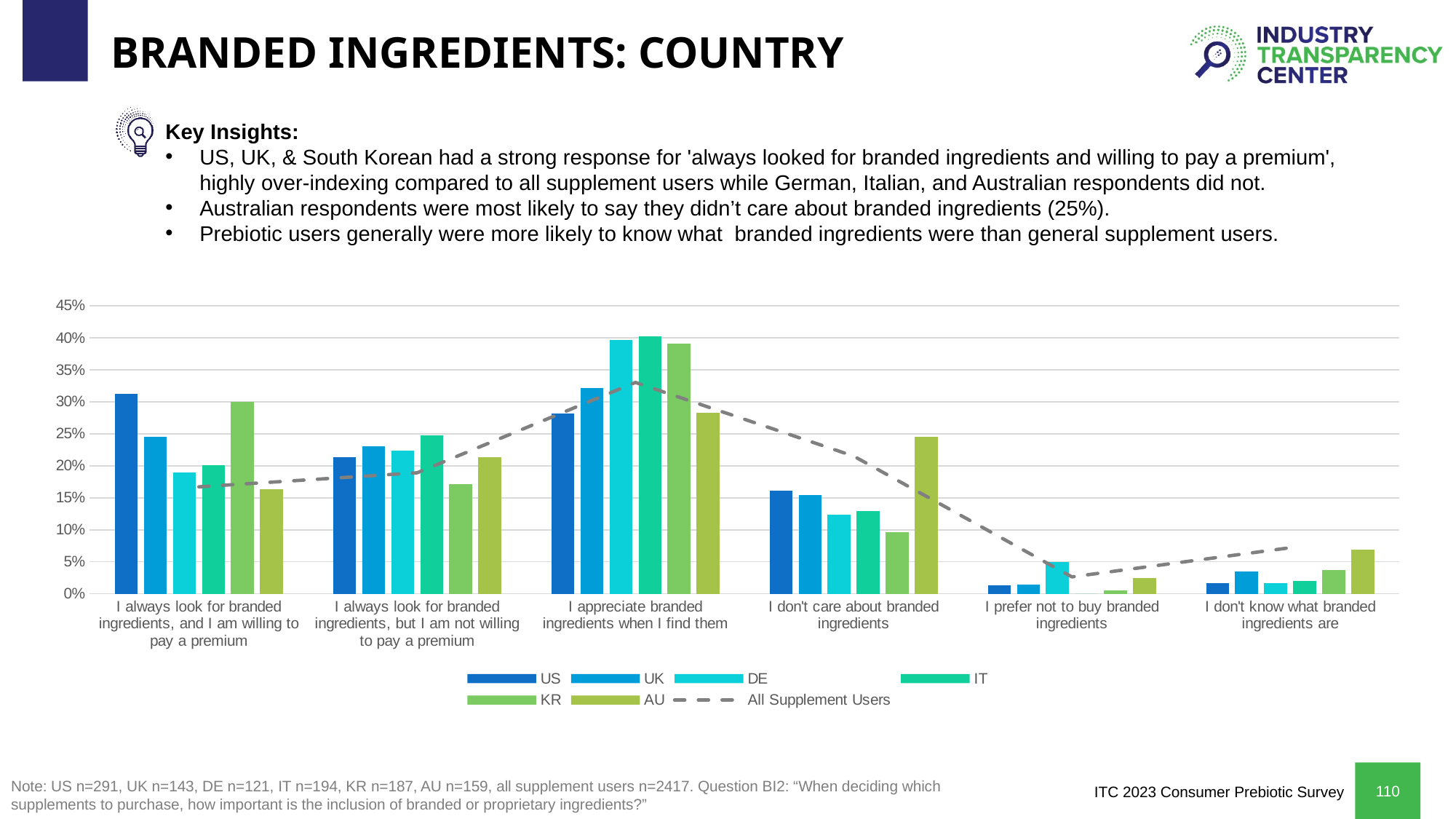
How many series does the chart legend list? 7 How many response categories are shown along the x axis of the chart? 6 Is the value for AU in 'I don't care about branded ingredients' greater or less than 20%? greater Is the value for US in 'I always look for branded ingredients, and I am willing to pay a premium' greater or less than 25%? greater In 'I appreciate branded ingredients when I find them', which is larger, the value for DE or the value for US? DE Which country has the lowest value for 'I always look for branded ingredients, and I am willing to pay a premium'? AU Which country has the highest value for 'I don't care about branded ingredients'? AU Which country has the lowest value for 'I don't care about branded ingredients'? KR Does the All Supplement Users line rise or fall between 'I appreciate branded ingredients when I find them' and 'I prefer not to buy branded ingredients'? fall Which series is drawn as a dashed line in the chart? All Supplement Users Is the value for DE in 'I appreciate branded ingredients when I find them' greater or less than 35%? greater What kind of chart is shown on the slide? combination bar and line chart